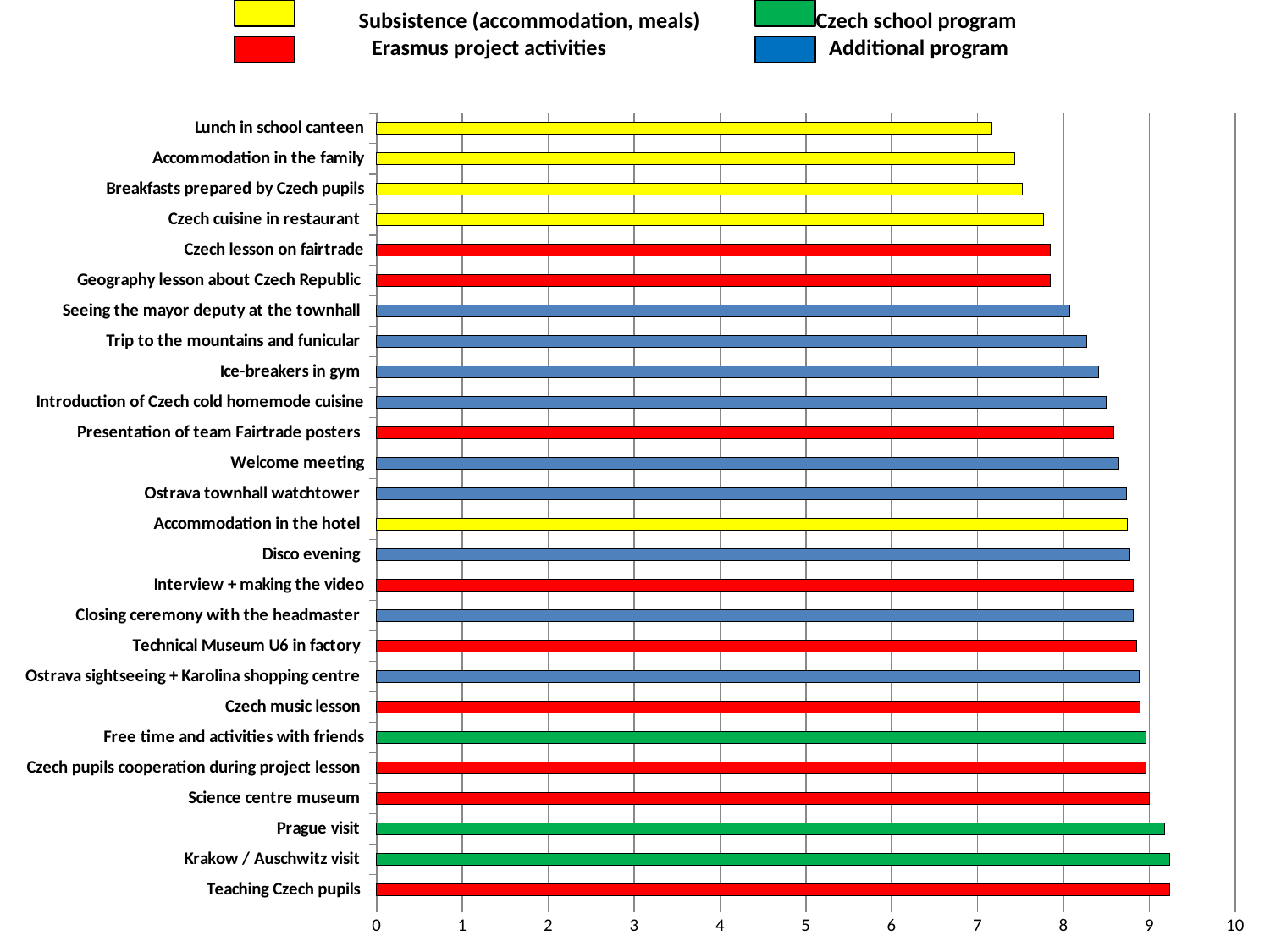
Which has the larger value, Czech cuisine in restaurant or Ice-breakers in gym? Ice-breakers in gym What colour represents the Czech school program series in the legend? green Which has the larger value, Lunch in school canteen or Prague visit? Prague visit Is the value for Prague visit greater or less than 9? greater Is the value for Trip to the mountains and funicular greater or less than 8? greater How many categories (activities) are plotted on the chart? 26 Is the value for Lunch in school canteen greater or less than 8? less Which legend entry is shown in yellow? Subsistence (accommodation, meals) Which activity has the lowest value on the chart? Lunch in school canteen What kind of chart is shown on the slide? bar chart How many series does the legend list? 4